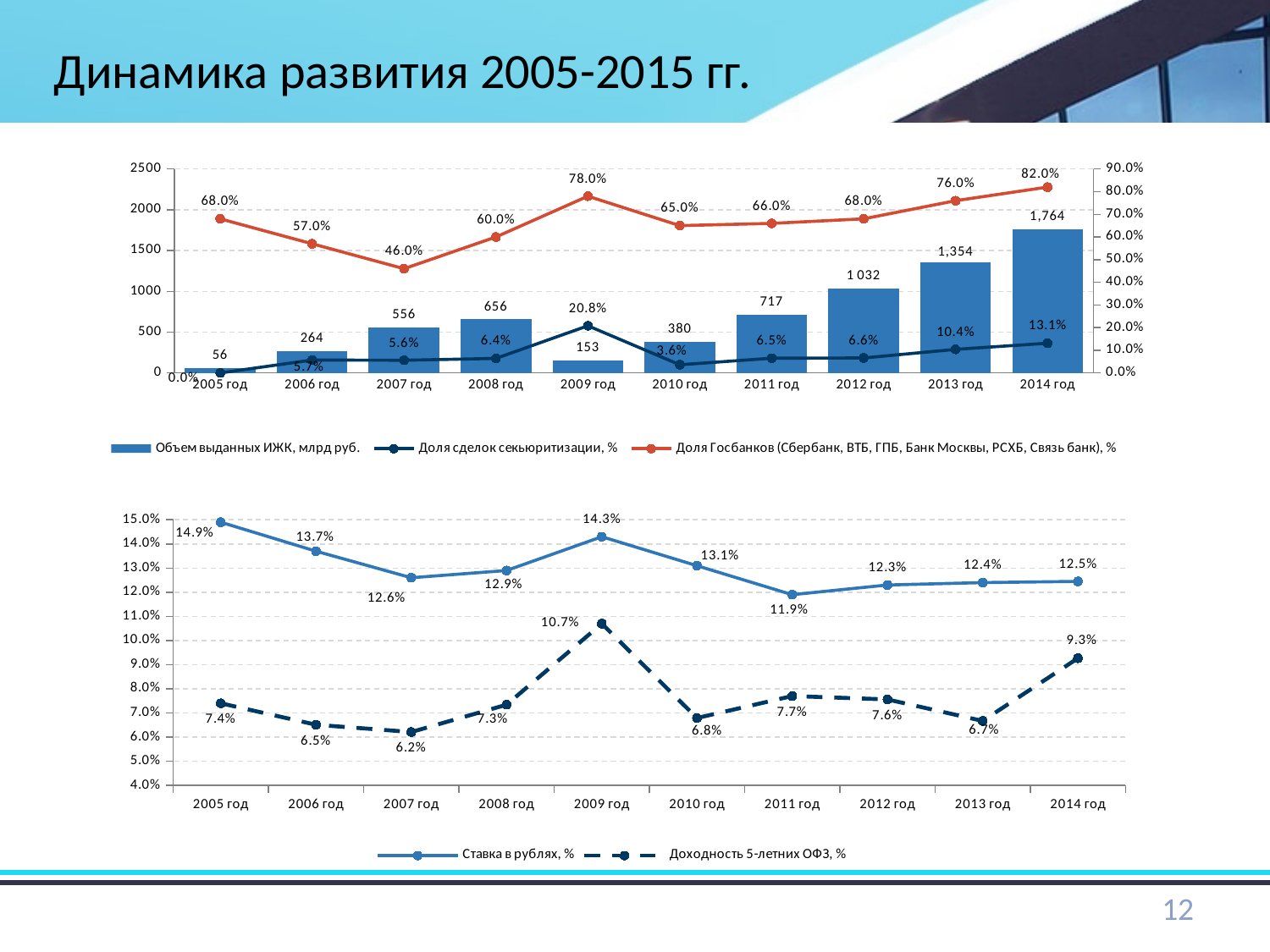
In the top chart, is the Объем выданных ИЖК bar for 2012 год larger or smaller than the bar for 2011 год? larger How many years are shown on the x axis of the bottom chart? 10 In the top chart, which year has the lowest value of Доля Госбанков? 2007 год In the top chart, what is the value of Объем выданных ИЖК, млрд руб. for 2014 год? 1,764 In the bottom chart, which year has the lowest value of Ставка в рублях, %? 2011 год In the bottom chart, what is the difference between Ставка в рублях and Доходность 5-летних ОФЗ for 2014 год? 3.2% In the top chart, what is the difference between the Объем выданных ИЖК values for 2008 год and 2009 год? 503 In the bottom chart, which year has the highest value of Доходность 5-летних ОФЗ, %? 2009 год In the top chart, what is the value of Доля Госбанков for 2009 год? 78.0% In the top chart, which year has the highest value of Доля сделок секьюритизации, %? 2009 год In the top chart, how many series does the legend list? 3 In the bottom chart, what is the value of Ставка в рублях, % for 2005 год? 14.9%